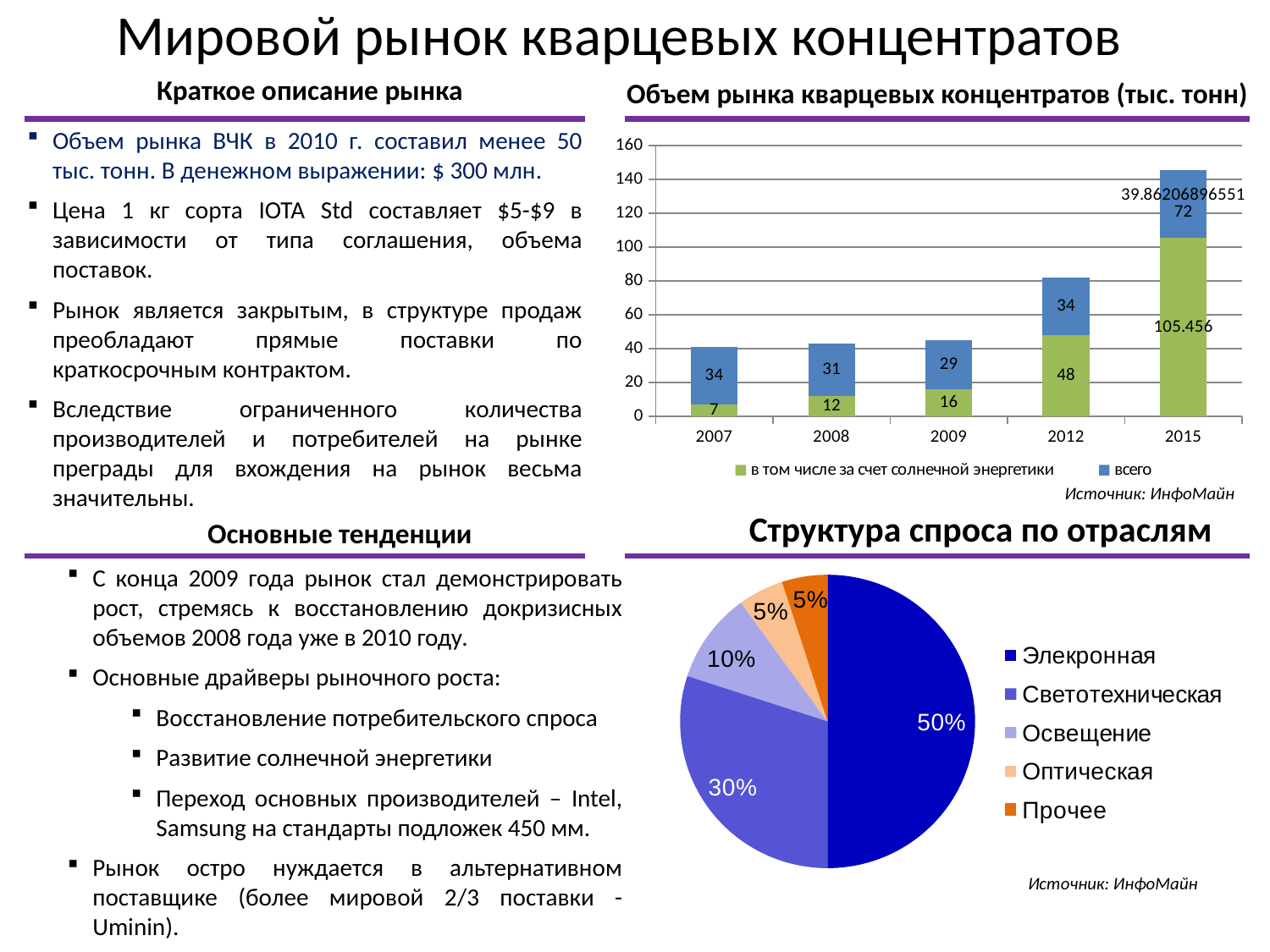
In the chart 'Объем рынка кварцевых концентратов (тыс. тонн)', what is the value of the series 'в том числе за счет солнечной энергетики' for 2015? 105.456 In the chart 'Объем рынка кварцевых концентратов (тыс. тонн)', what is the value of the series 'всего' for 2008? 31 In the chart 'Объем рынка кварцевых концентратов (тыс. тонн)', does the series 'в том числе за счет солнечной энергетики' rise or fall from 2007 to 2015? Rises In the pie chart 'Структура спроса по отраслям', what share does 'Элекронная' have? 50% In the chart 'Объем рынка кварцевых концентратов (тыс. тонн)', what is the value of the series 'в том числе за счет солнечной энергетики' for 2007? 7 In the pie chart 'Структура спроса по отраслям', which category has the largest share? Элекронная How many series does the legend of the chart 'Объем рынка кварцевых концентратов (тыс. тонн)' list? 2 What kind of chart is 'Объем рынка кварцевых концентратов (тыс. тонн)'? Stacked bar chart How many years are shown on the x axis of the chart 'Объем рынка кварцевых концентратов (тыс. тонн)'? 5 In the chart 'Объем рынка кварцевых концентратов (тыс. тонн)', what is the difference between the 2012 and 2009 values of the series 'в том числе за счет солнечной энергетики'? 32 In the chart 'Объем рынка кварцевых концентратов (тыс. тонн)', which year has the highest value for the series 'в том числе за счет солнечной энергетики'? 2015 In the chart 'Объем рынка кварцевых концентратов (тыс. тонн)', what is the total of the stacked bar for 2012? 82